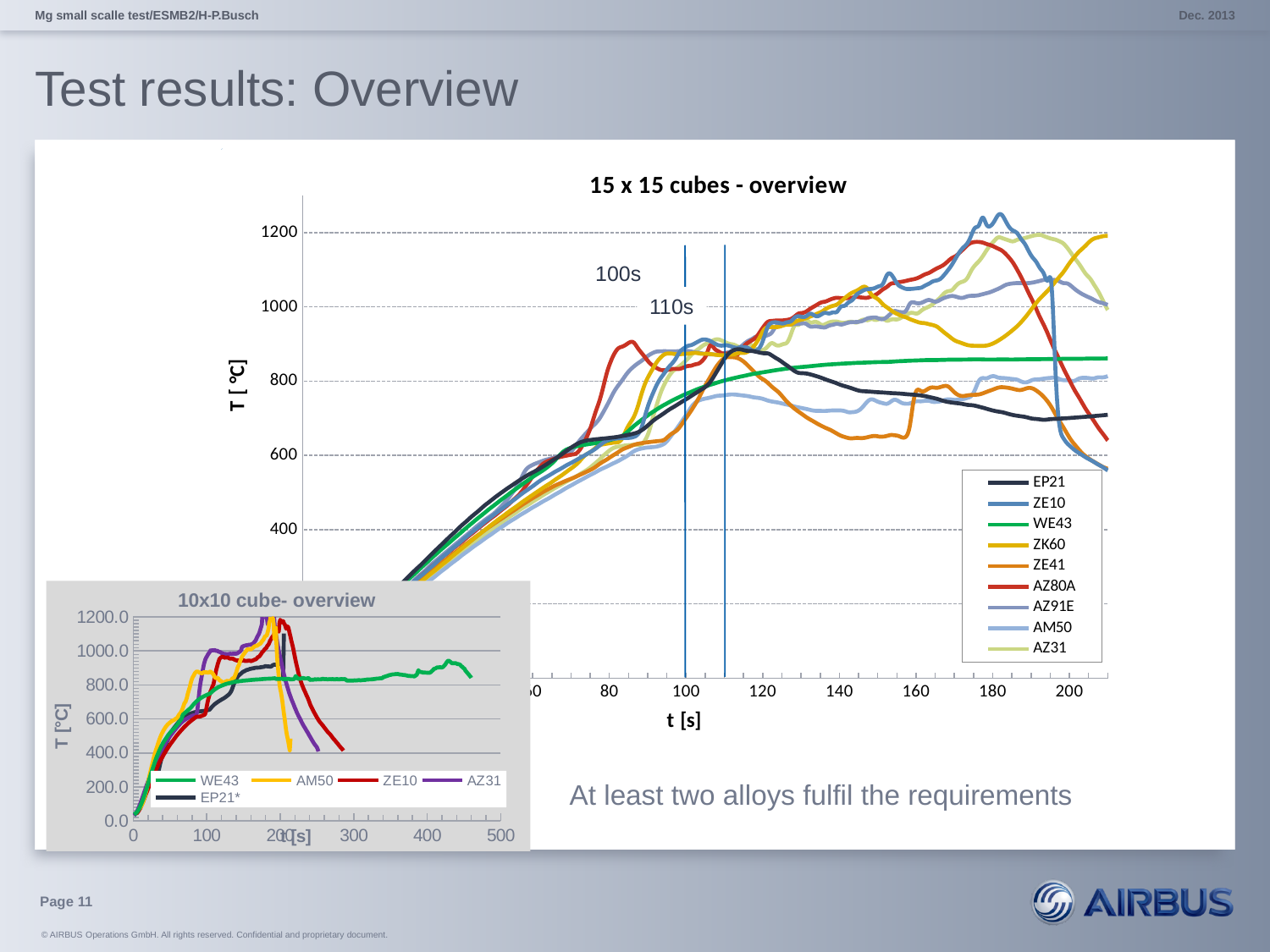
How many series does the legend of the '15 x 15 cubes - overview' chart list? 9 How many series does the legend of the '10x10 cube- overview' chart list? 5 In the '15 x 15 cubes - overview' chart, is the peak value of ZE10 greater or less than 1200? greater What kind of chart is the '15 x 15 cubes - overview' chart? line chart In the '15 x 15 cubes - overview' chart, does the EP21 line rise or fall between t = 120 and t = 180? fall In the '15 x 15 cubes - overview' chart, is the value for WE43 at t = 200 greater or less than 800? greater In the '15 x 15 cubes - overview' chart, what is the label of the y axis? T [°C] In the '15 x 15 cubes - overview' chart, is the value for ZE41 at t = 160 greater or less than 800? less What kind of chart is the '10x10 cube- overview' chart? line chart In the '15 x 15 cubes - overview' chart, does the WE43 line rise or fall between t = 120 and t = 200? rise In the '15 x 15 cubes - overview' chart, what is the label of the x axis? t [s]